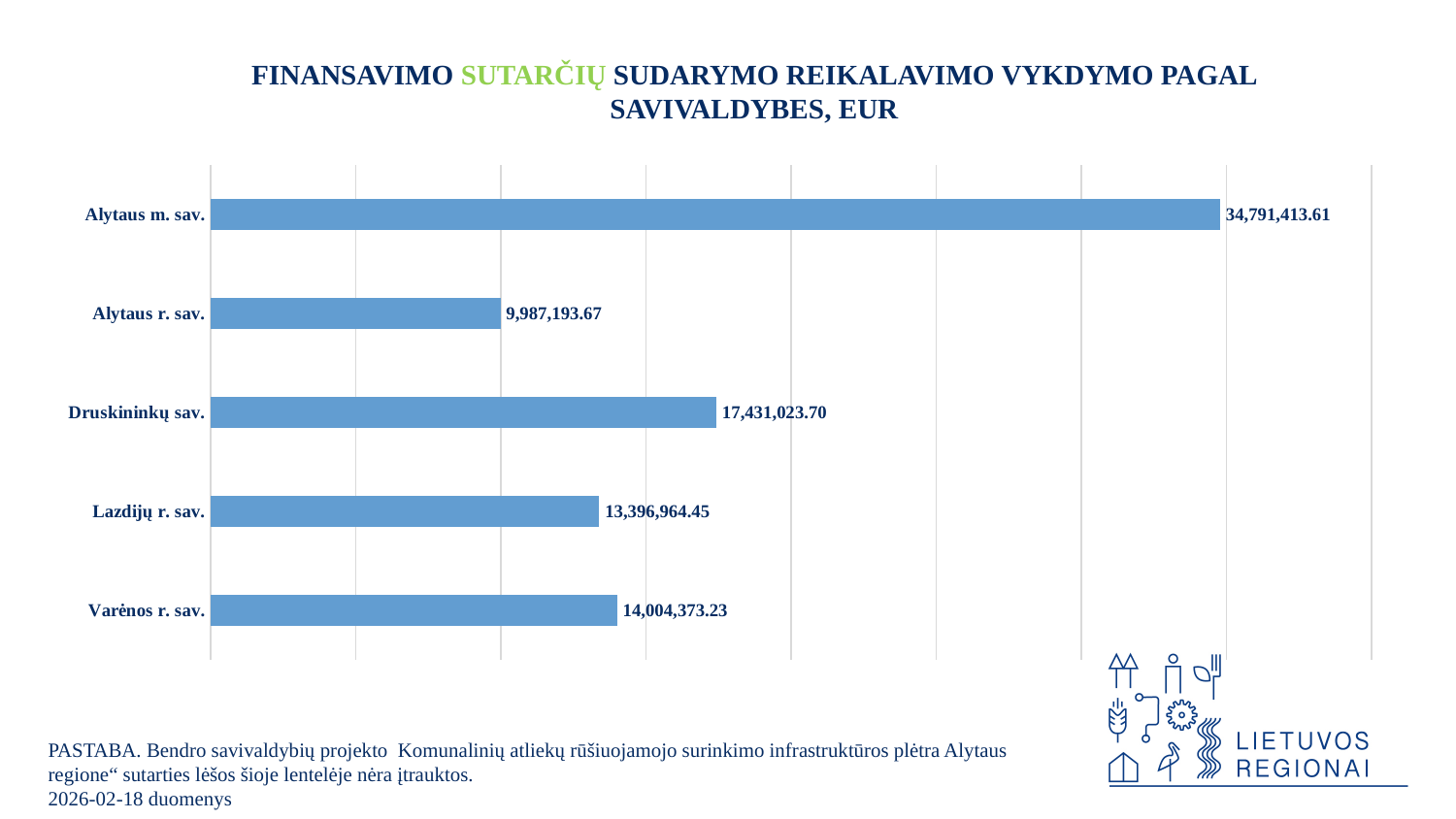
What is the value for Lazdijų r. sav.? 13,396,964.45 What is the value for Alytaus m. sav.? 34,791,413.61 Which municipality has the highest value? Alytaus m. sav. What is the value for Druskininkų sav.? 17,431,023.70 How many municipalities are shown in the chart? 5 What is the difference between the values for Alytaus m. sav. and Alytaus r. sav.? 24,804,219.94 What is the value for Varėnos r. sav.? 14,004,373.23 What is the difference between the values for Druskininkų sav. and Lazdijų r. sav.? 4,034,059.25 What kind of chart is shown on the slide? Bar chart What unit is stated in the chart title? EUR Which municipality has the lowest value? Alytaus r. sav. Which has the larger value, Varėnos r. sav. or Lazdijų r. sav.? Varėnos r. sav.